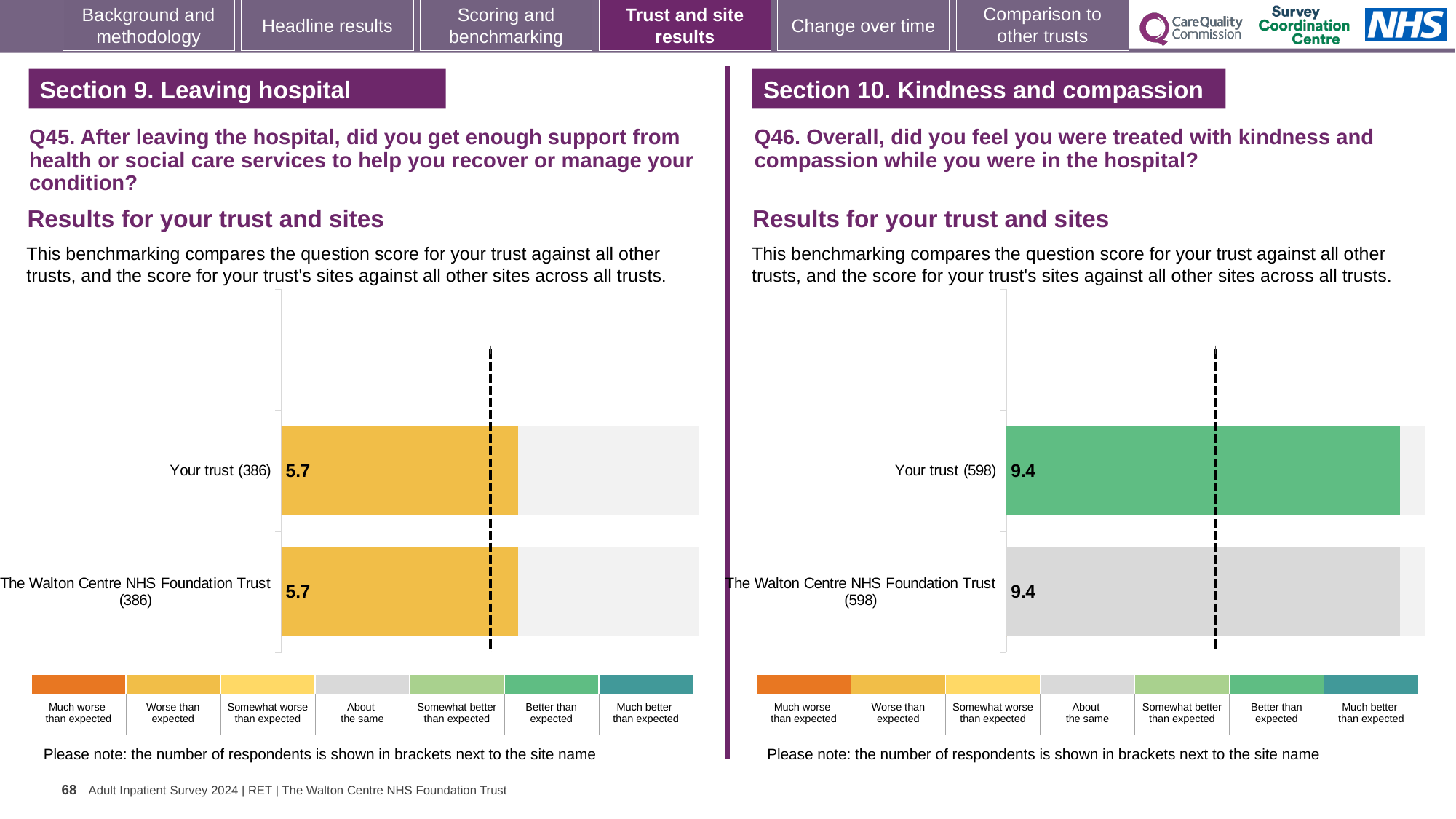
In the Q45 chart on the left, what is the score for The Walton Centre NHS Foundation Trust (386)? 5.7 How many bars are plotted in the Q46 chart on the right? 2 In the Q46 chart on the right, what is the difference between the score for Your trust and the score for The Walton Centre NHS Foundation Trust? 0 In the Q46 chart on the right, what is the score for Your trust (598)? 9.4 How many bars are plotted in the Q45 chart on the left? 2 In the Q45 chart on the left, what is the score for Your trust (386)? 5.7 What kind of chart is used for the Q45 results on the left? Bar chart How many respondents are shown in brackets for Your trust in the Q46 chart on the right? 598 In the Q45 chart on the left, what is the difference between the score for Your trust and the score for The Walton Centre NHS Foundation Trust? 0 In the Q46 chart on the right, what is the score for The Walton Centre NHS Foundation Trust (598)? 9.4 In the Q45 chart on the left, which benchmark category does the colour of the bars correspond to according to the colour key? Worse than expected In the Q46 chart on the right, which benchmark category does the colour of the Your trust (598) bar correspond to according to the colour key? Better than expected